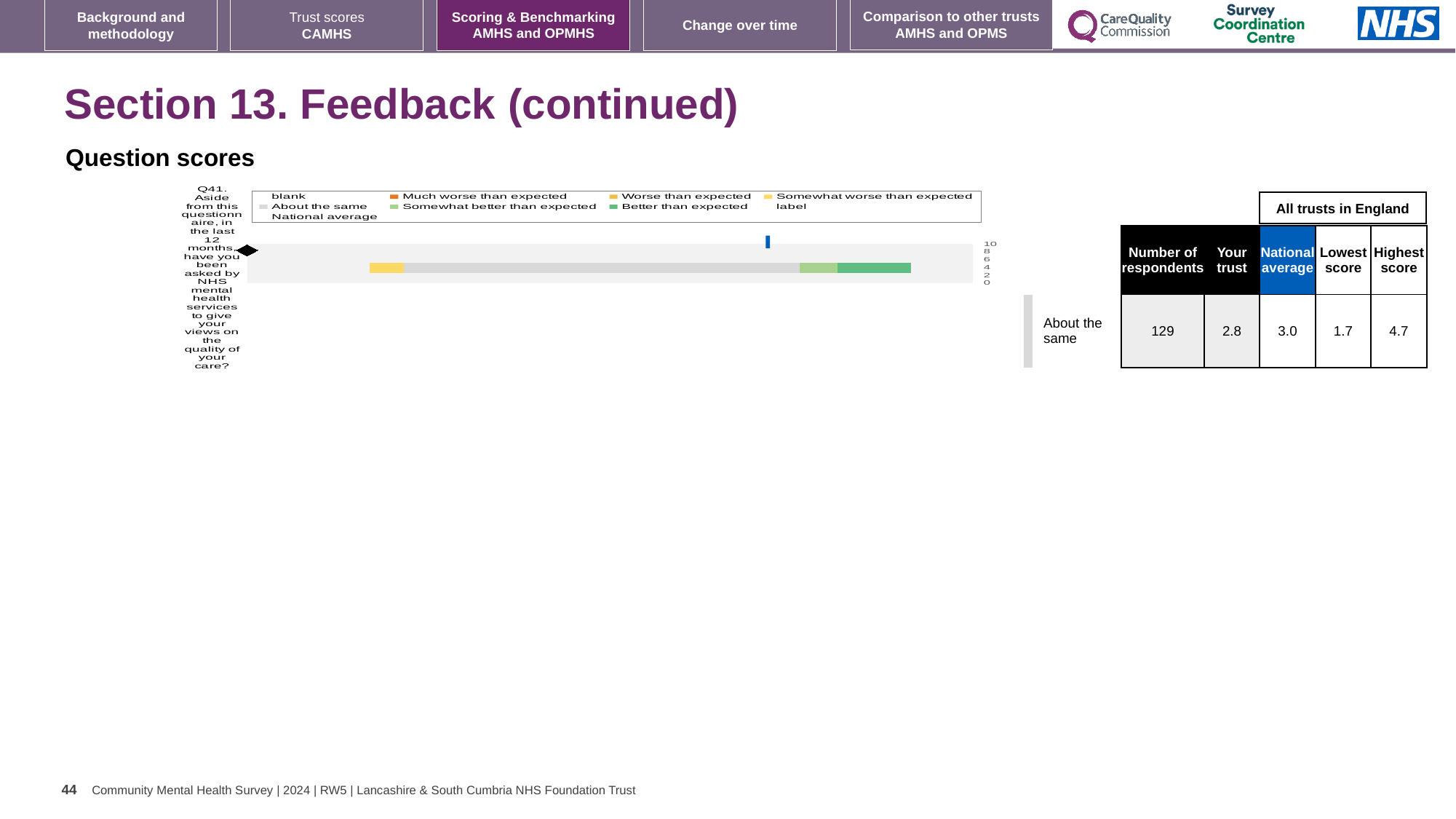
How many bars (questions) does the chart plot? 1 According to the table next to the chart, what is the lowest score among all trusts in England for Q41? 1.7 How is the trust's result for Q41 categorised relative to other trusts? About the same According to the table next to the chart, what is the 'Your trust' score for Q41? 2.8 In the chart legend, which colour represents 'Much worse than expected'? orange According to the table next to the chart, what is the national average score for Q41? 3.0 According to the table next to the chart, what is the highest score among all trusts in England for Q41? 4.7 Which is larger for Q41: the 'Your trust' score or the national average? national average Which question number is plotted in the chart? Q41 What is the difference between the highest score and the lowest score for Q41 in the table? 3.0 What kind of chart is shown on the slide? bar chart According to the table next to the chart, what is the number of respondents for Q41? 129